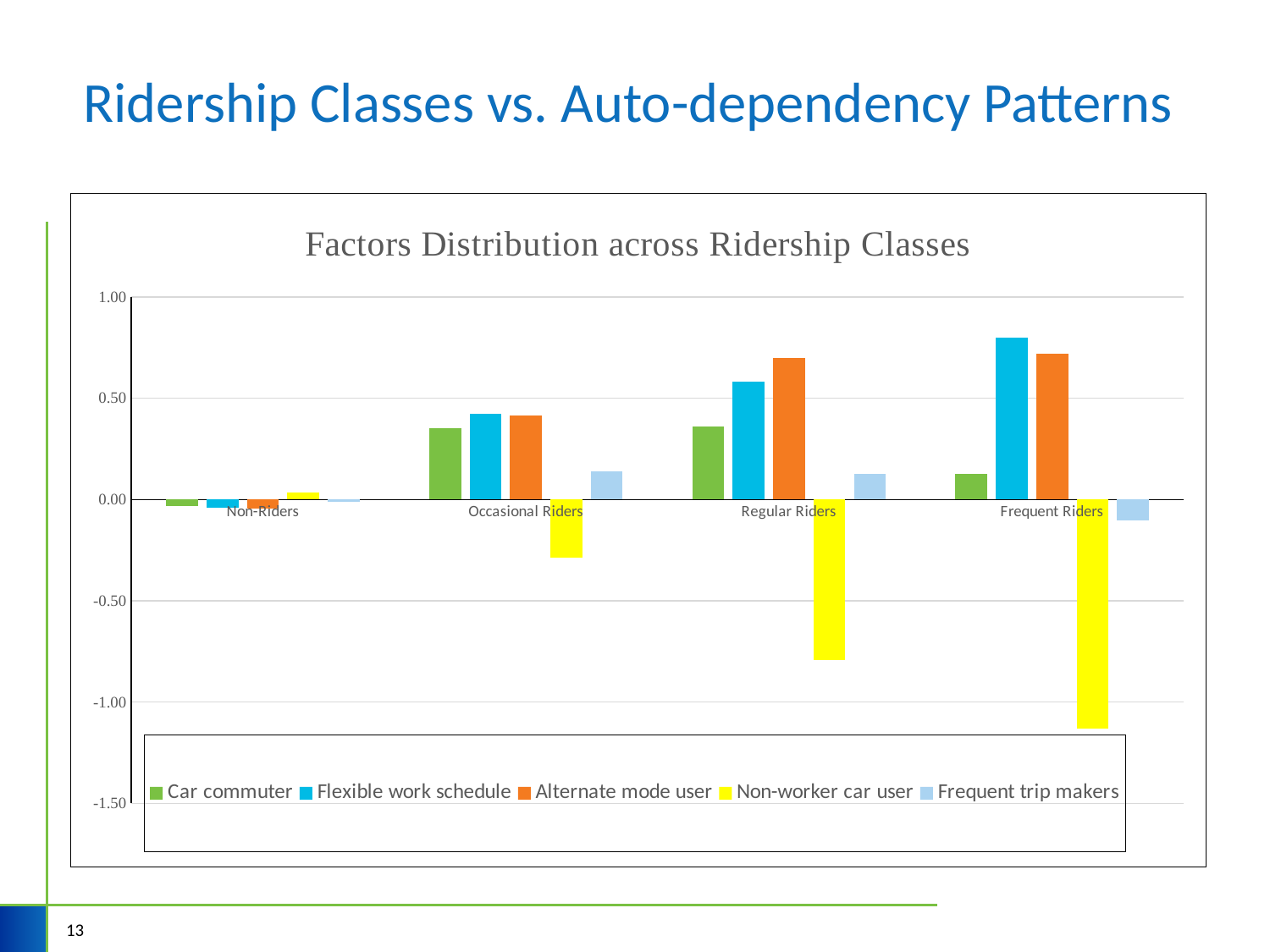
How many series does the legend list? 5 What is the title of the chart? Factors Distribution across Ridership Classes Which ridership class has the highest value for Flexible work schedule? Frequent Riders Which colour represents Non-worker car user in the chart? yellow What kind of chart is shown on the slide? bar chart Is the value for Alternate mode user among Regular Riders greater or less than 0.50? greater Is the value for Car commuter among Occasional Riders greater or less than 0.50? less Is the value for Non-worker car user among Frequent Riders greater or less than -1.00? less For Regular Riders, which is larger: Alternate mode user or Flexible work schedule? Alternate mode user How many ridership classes are shown on the x axis? 4 Which ridership class has the lowest value for Non-worker car user? Frequent Riders Do the values for Non-worker car user rise or fall from Non-Riders to Frequent Riders? fall